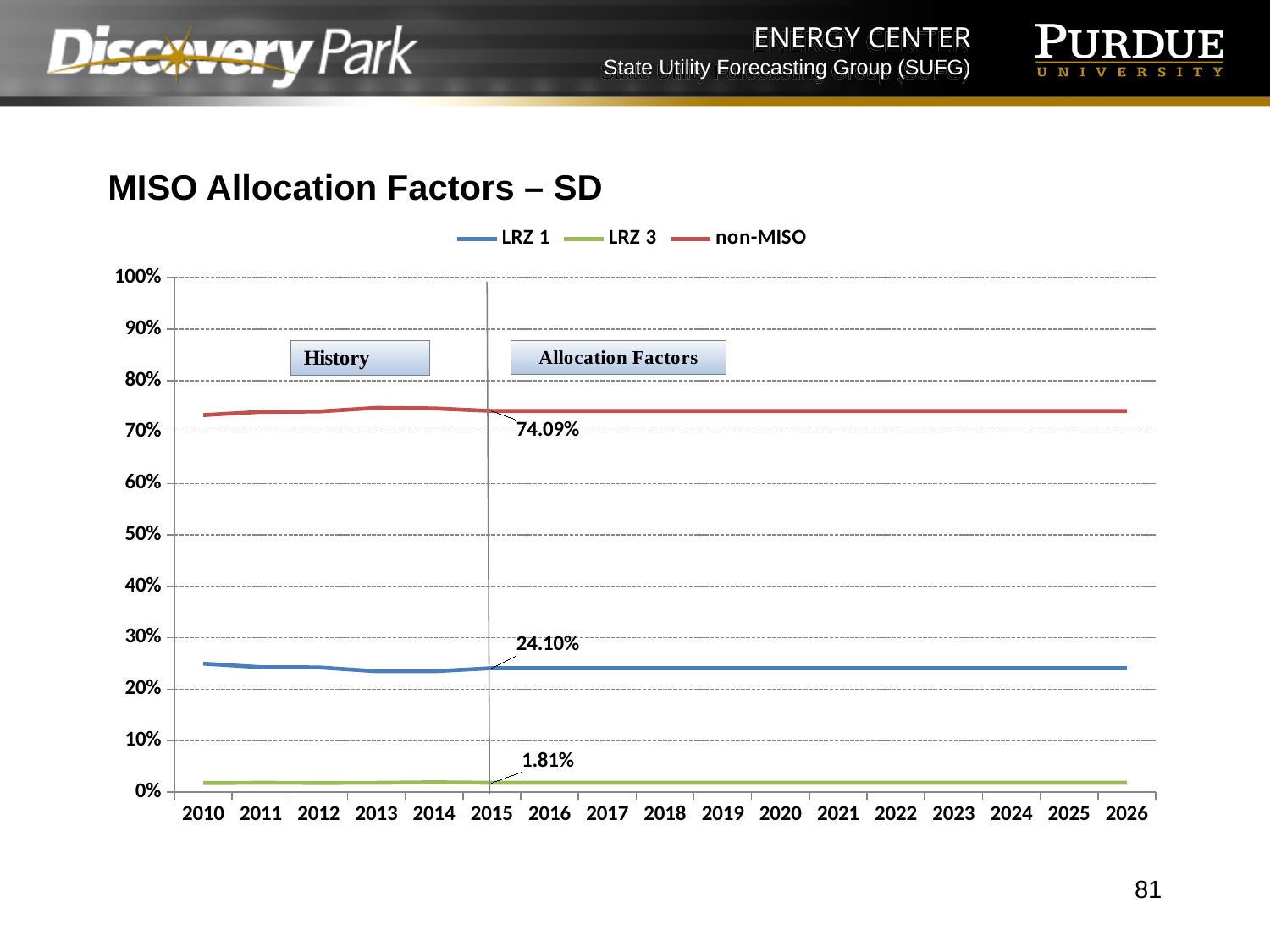
Is the value for LRZ 1 in 2026 greater or less than 30%? less Which series has the lowest value in 2015? LRZ 3 Is the value for non-MISO in 2010 greater or less than 70%? greater What is the value labelled for the LRZ 1 series in 2015? 24.10% What is the value labelled for the LRZ 3 series in 2015? 1.81% How many series does the legend list? 3 What is the value labelled for the non-MISO series in 2015? 74.09% How many years are shown on the x axis? 17 What is the title of the chart? MISO Allocation Factors – SD What is the difference between the non-MISO and LRZ 1 values labelled in 2015? 49.99% What type of chart is shown on the slide? line chart Which series has the highest value in 2015? non-MISO